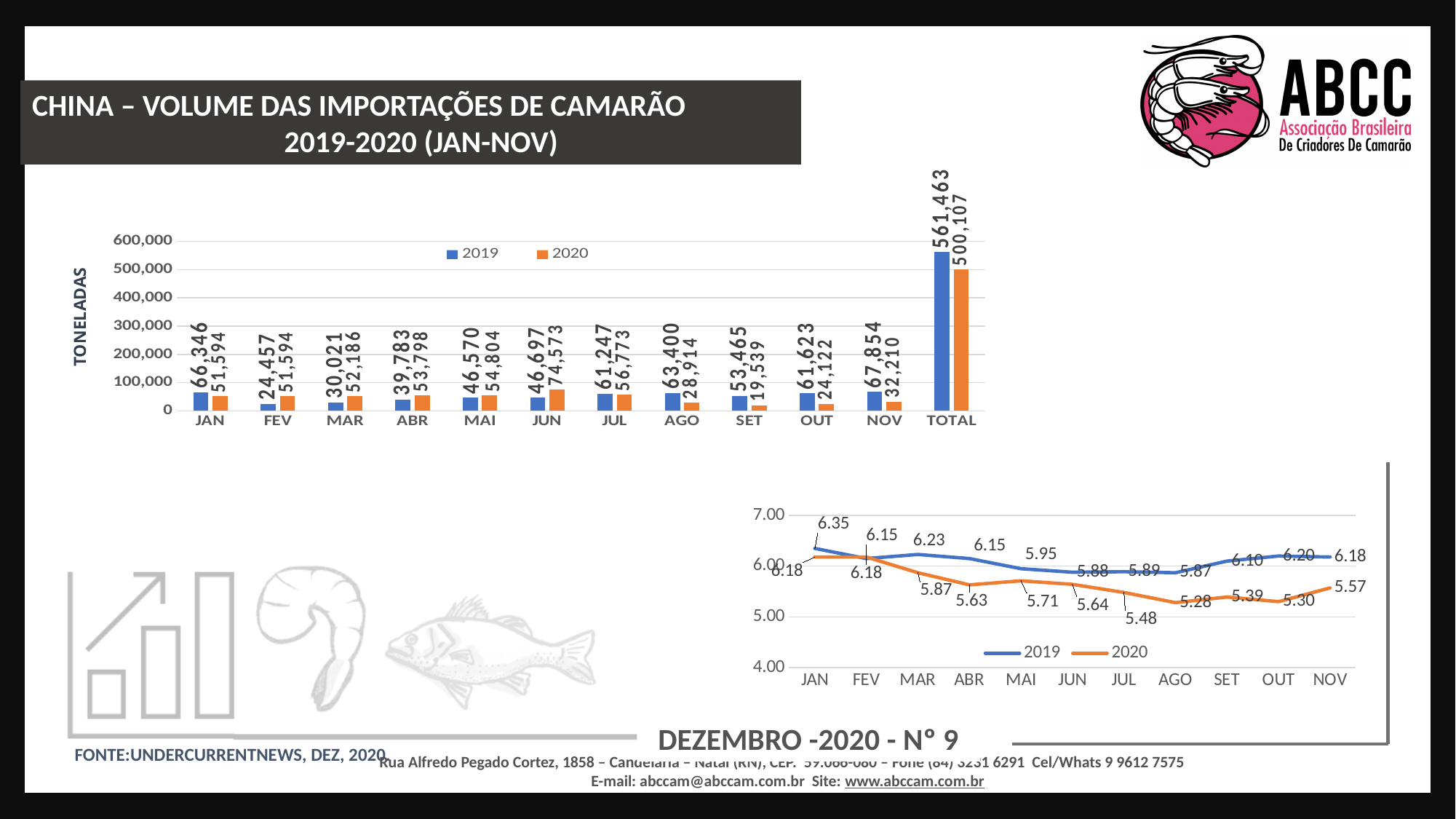
In the bottom line chart, what is the difference between the 2019 and 2020 values for NOV? 0.61 In the top bar chart, which month has the lowest 2019 value? FEV In the bottom line chart, which month has the lowest 2020 value? AGO How many series does the legend of the bottom line chart list? 2 What type of chart is the top chart on the slide? Bar chart In the top bar chart, which is larger for AGO, the 2019 value or the 2020 value? 2019 In the top bar chart, which month has the highest 2020 value? JUN In the top bar chart, what is the 2019 value for NOV? 67,854 In the bottom line chart, what is the 2020 value for JUL? 5.48 In the top bar chart, what is the difference between the 2019 and 2020 TOTAL values? 61,356 In the top bar chart, what is the 2020 value for JUN? 74,573 In the top bar chart, what is the TOTAL value for 2020? 500,107